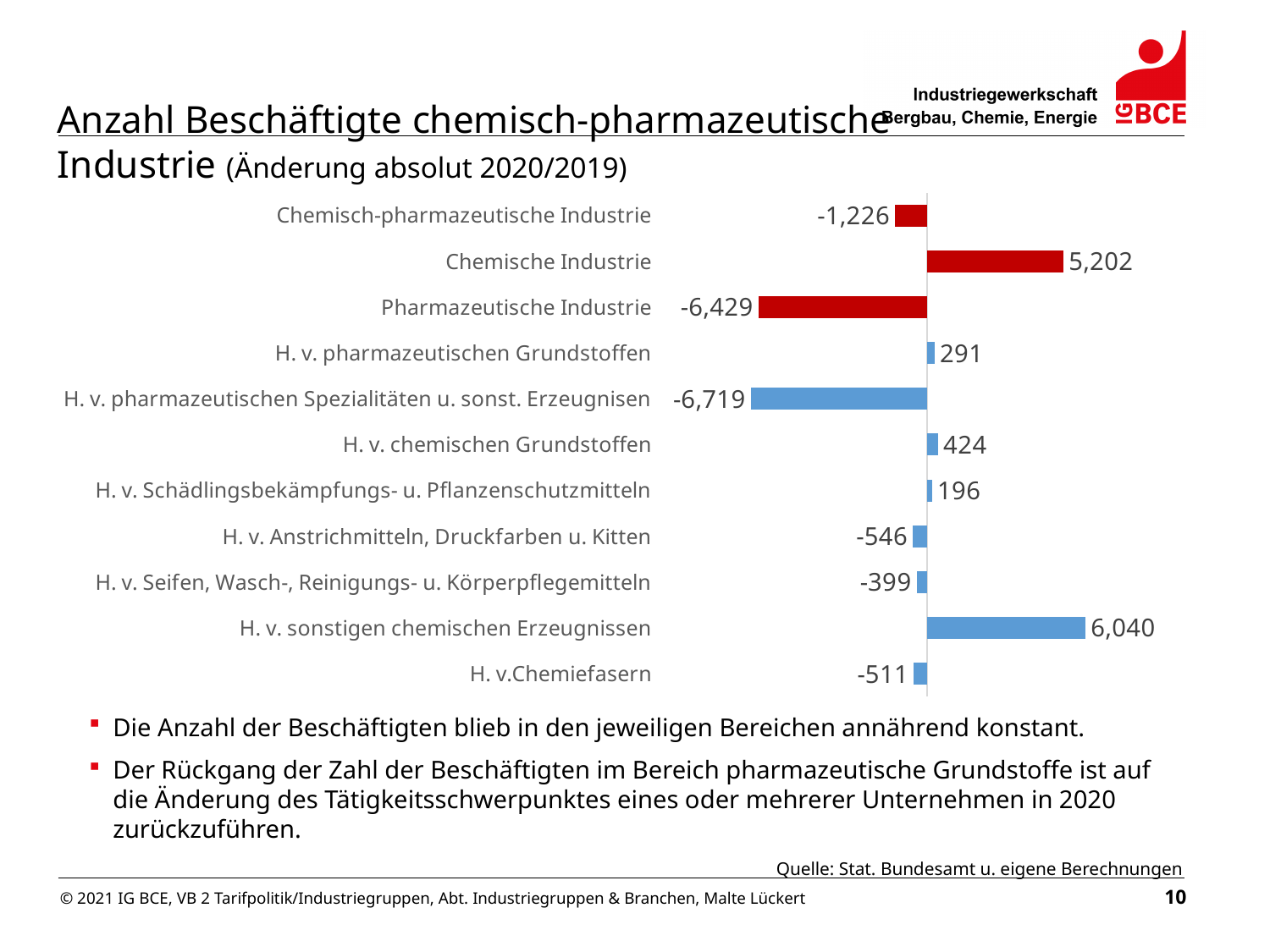
What is the value for H. v. Seifen, Wasch-, Reinigungs- u. Körperpflegemitteln? -399 What colour is the bar for Pharmazeutische Industrie? Red What kind of chart is shown on the slide? Bar chart What is the value for Chemische Industrie? 5,202 Which category has the lowest value? H. v. pharmazeutischen Spezialitäten u. sonst. Erzeugnissen Which is larger, the value for H. v. chemischen Grundstoffen or the value for H. v. Schädlingsbekämpfungs- u. Pflanzenschutzmitteln? H. v. chemischen Grundstoffen What is the value for Chemisch-pharmazeutische Industrie? -1,226 What is the difference between the values for H. v. sonstigen chemischen Erzeugnissen and Chemische Industrie? 838 How many categories are shown in the chart? 11 Which category has the highest value? H. v. sonstigen chemischen Erzeugnissen What is the difference between the values for H. v. chemischen Grundstoffen and H. v. pharmazeutischen Grundstoffen? 133 What is the value for H. v. pharmazeutischen Spezialitäten u. sonst. Erzeugnissen? -6,719